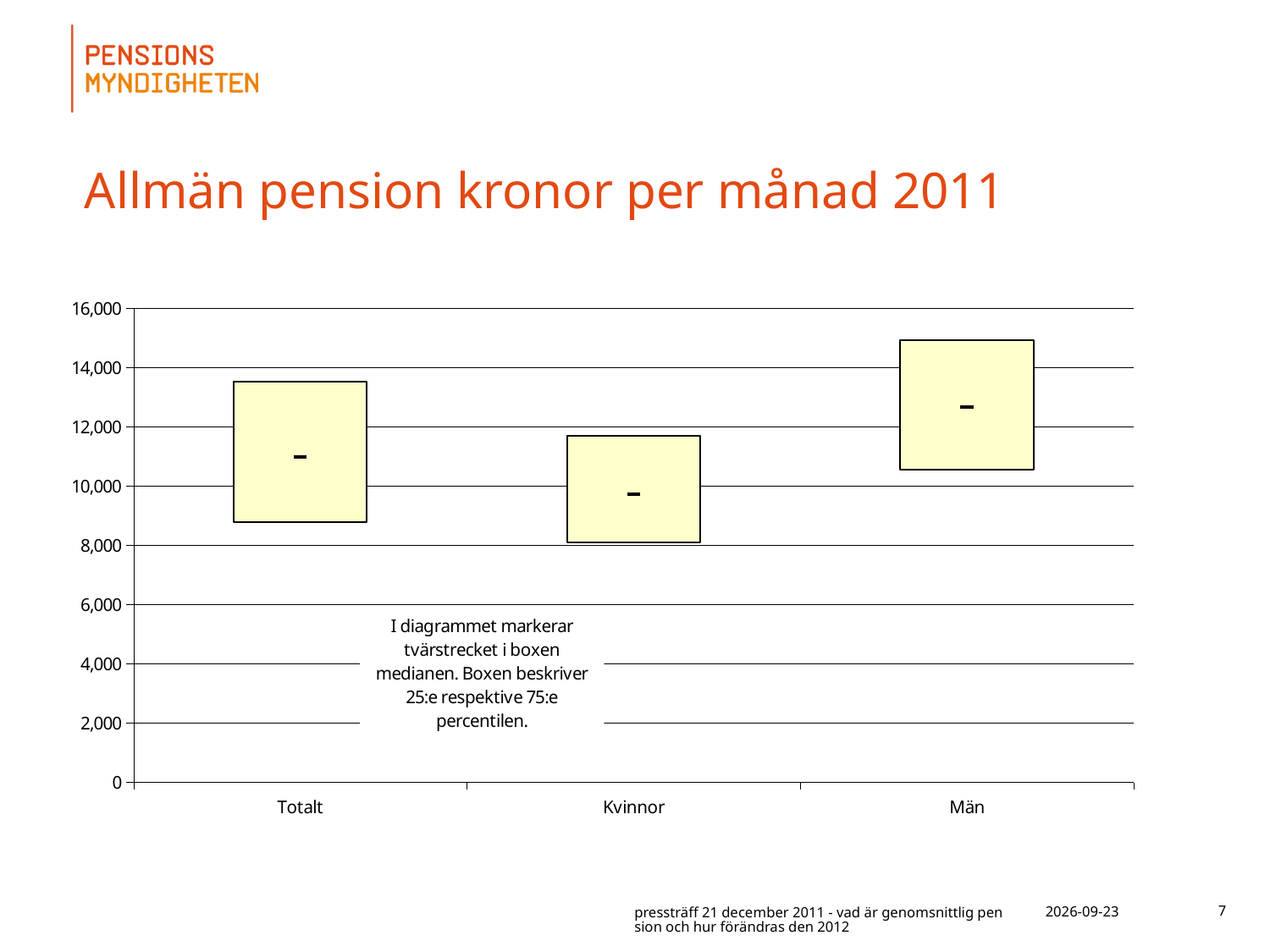
Is the median for Kvinnor greater or less than 10,000? less Is the top of the box for Män greater or less than 14,000? greater Is the median for Totalt greater or less than 10,000? greater Which category has the highest median (the cross mark in the box)? Män Which has a higher median, Totalt or Kvinnor? Totalt What is the title of the chart on the slide? Allmän pension kronor per månad 2011 How many categories are shown on the x axis of the chart? 3 Which category has the lowest median (the cross mark in the box)? Kvinnor Which category's box reaches the highest value on the chart? Män According to the note in the chart, what does the cross mark in each box represent? Medianen (the median)